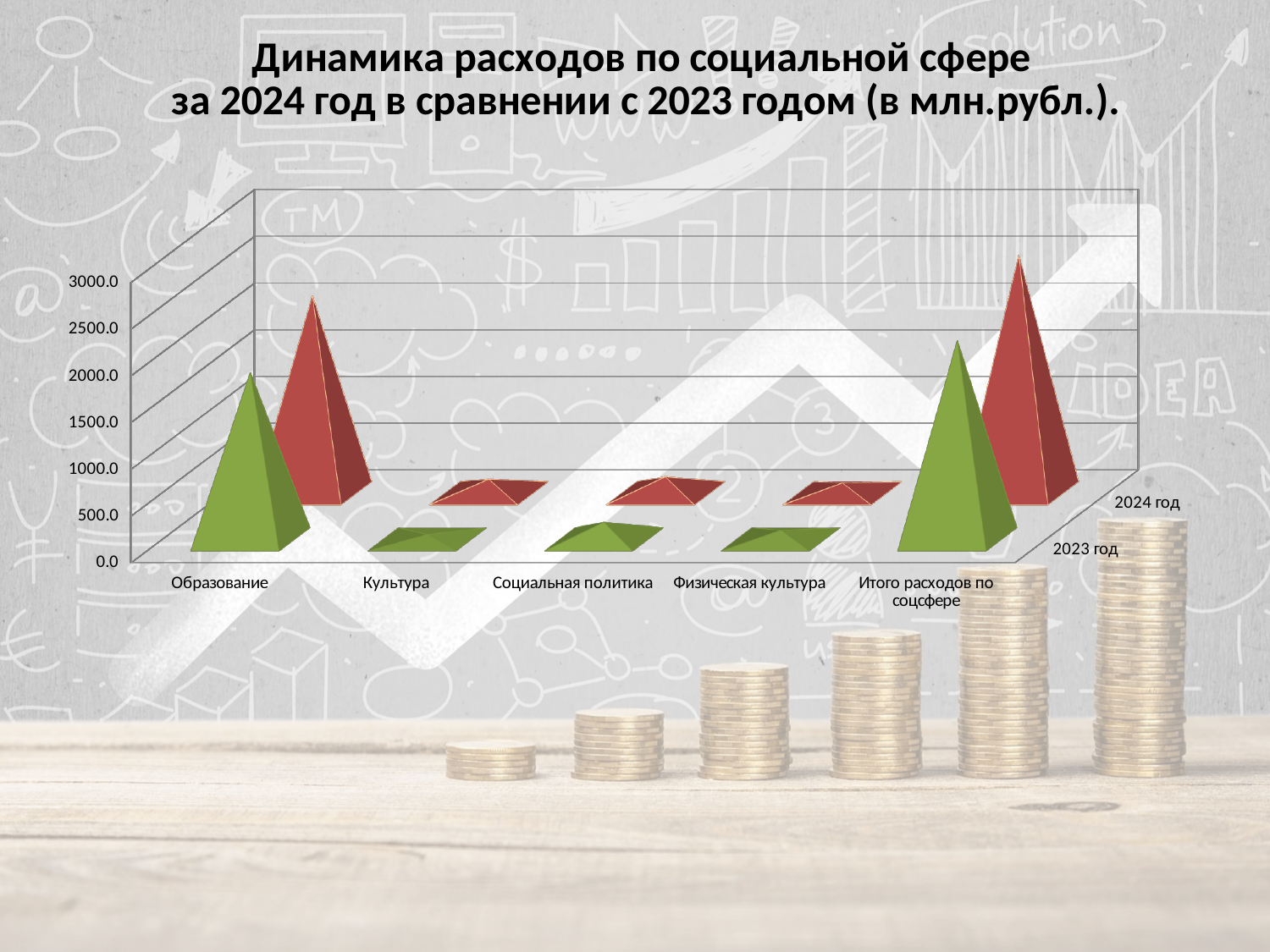
For Итого расходов по соцсфере, which series has the larger value: 2023 год or 2024 год? 2024 год Which category has the highest value for the 2023 год series? Итого расходов по соцсфере Which is larger for 2024 год: Образование or Культура? Образование Is the value for Физическая культура in 2024 год greater or less than 500.0? less Is the value for Культура in 2023 год greater or less than 500.0? less Which category has the highest value for the 2024 год series? Итого расходов по соцсфере What is the title of the chart? Динамика расходов по социальной сфере за 2024 год в сравнении с 2023 годом (в млн.рубл.). How many categories are shown on the x axis of the chart? 5 Is the value for Образование in 2024 год greater or less than 1500.0? greater What kind of chart is shown on the slide? bar chart